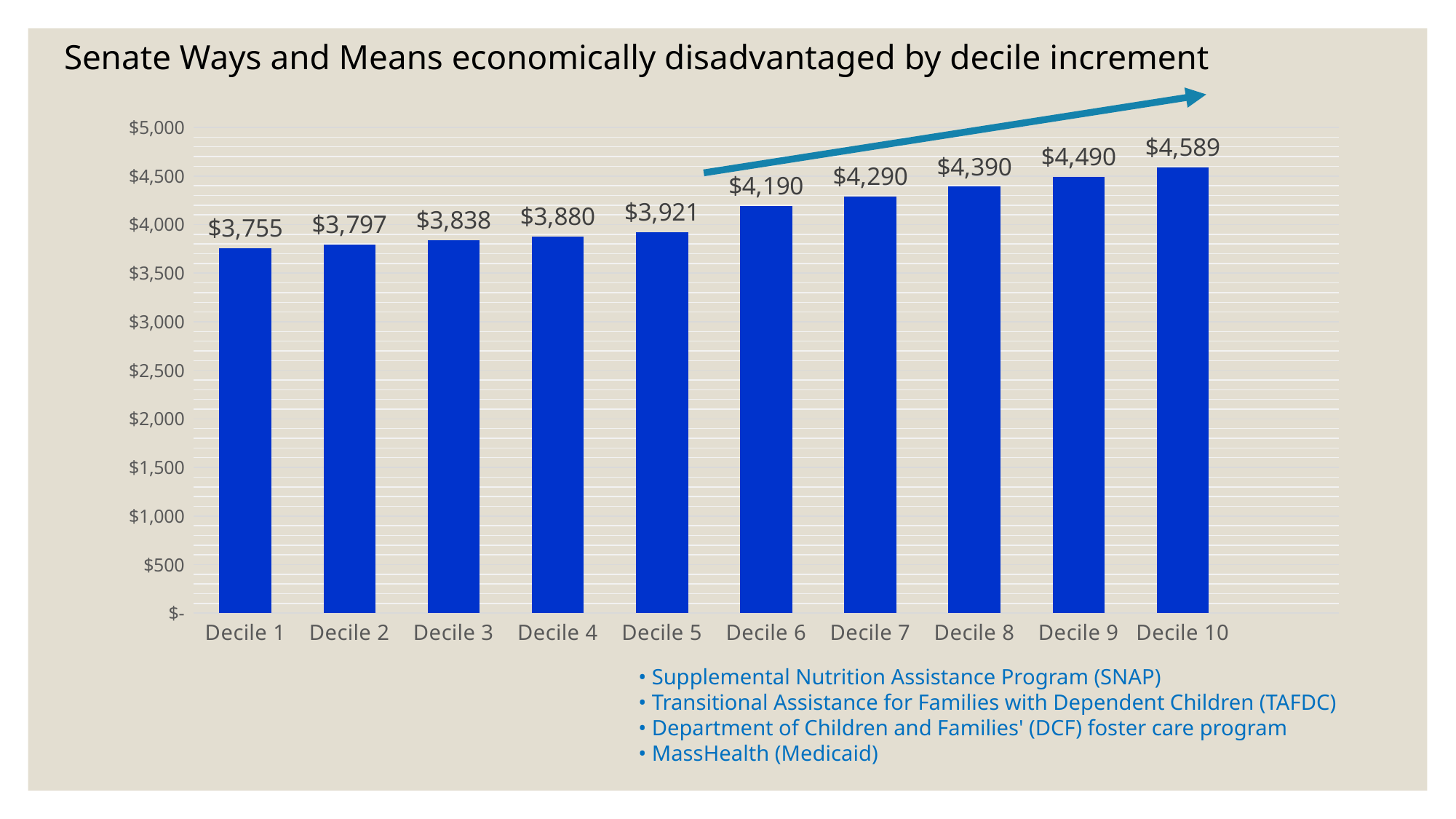
What is the difference between the values for Decile 10 and Decile 1? $834 What kind of chart is shown on the slide? Bar chart Is the value for Decile 4 greater or less than $4,000? less Which decile has the lowest value? Decile 1 Which is larger, the value for Decile 3 or the value for Decile 8? Decile 8 What is the value for Decile 10? $4,589 What is the value for Decile 6? $4,190 Which decile has the highest value? Decile 10 What is the value for Decile 1? $3,755 Do the values rise or fall from Decile 1 to Decile 10? Rise How many deciles are shown on the x axis? 10 What is the difference between the values for Decile 6 and Decile 5? $269